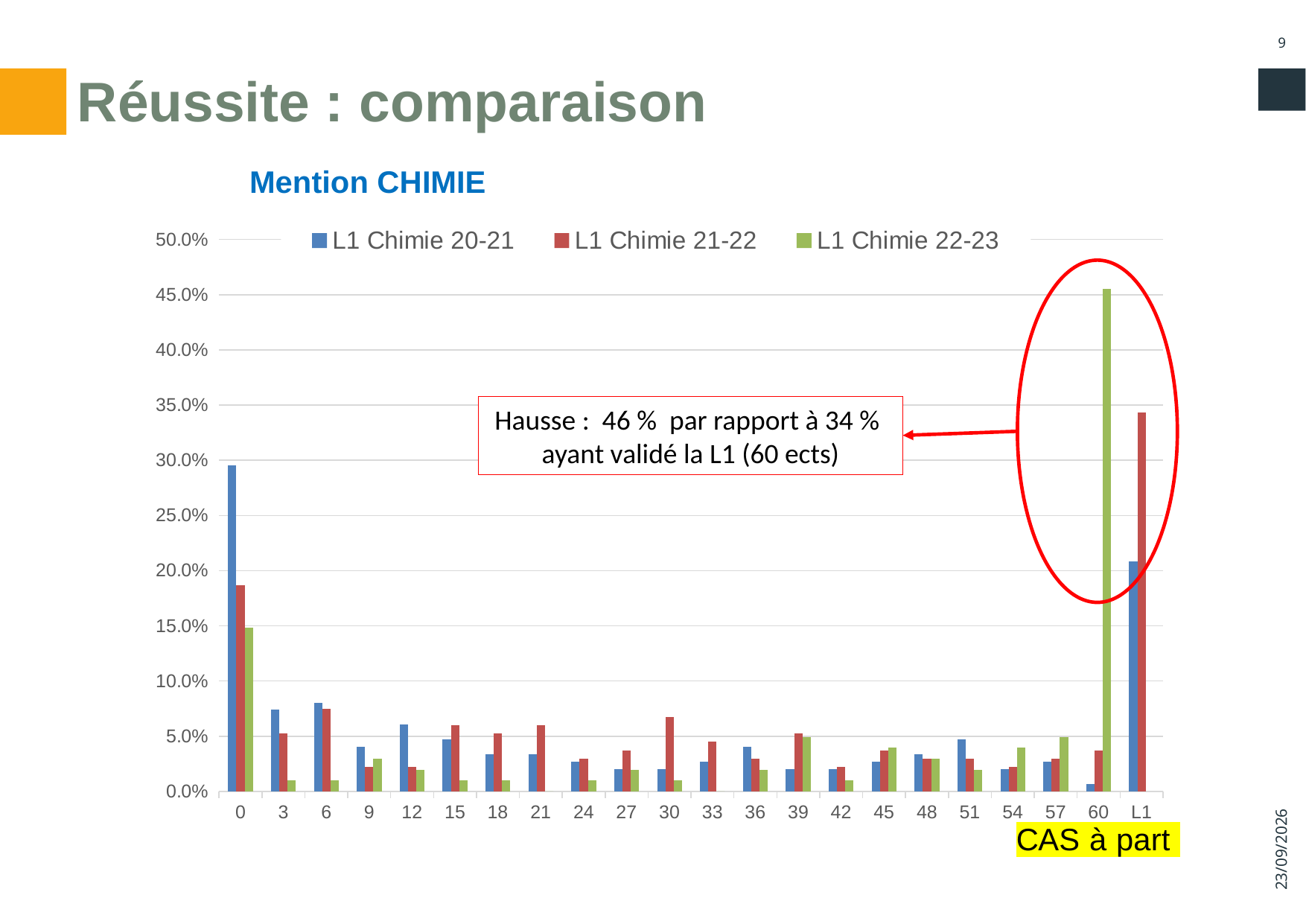
Is the value for L1 Chimie 22-23 at category 60 greater or less than 40.0%? greater What is the title of the chart? Mention CHIMIE For the L1 Chimie 22-23 series, which category has the highest value? 60 Is the value for L1 Chimie 21-22 at category L1 greater or less than 30.0%? greater At category 0, which series has the larger value: L1 Chimie 20-21 or L1 Chimie 22-23? L1 Chimie 20-21 For the L1 Chimie 21-22 series, which category has the highest value? L1 What kind of chart is shown on the slide? bar chart For the L1 Chimie 20-21 series, which category has the highest value? 0 Is the value for L1 Chimie 20-21 at category 0 greater or less than 25.0%? greater Which colour represents the L1 Chimie 22-23 series? green How many series does the chart legend list? 3 How many categories are shown along the x axis of the chart? 22